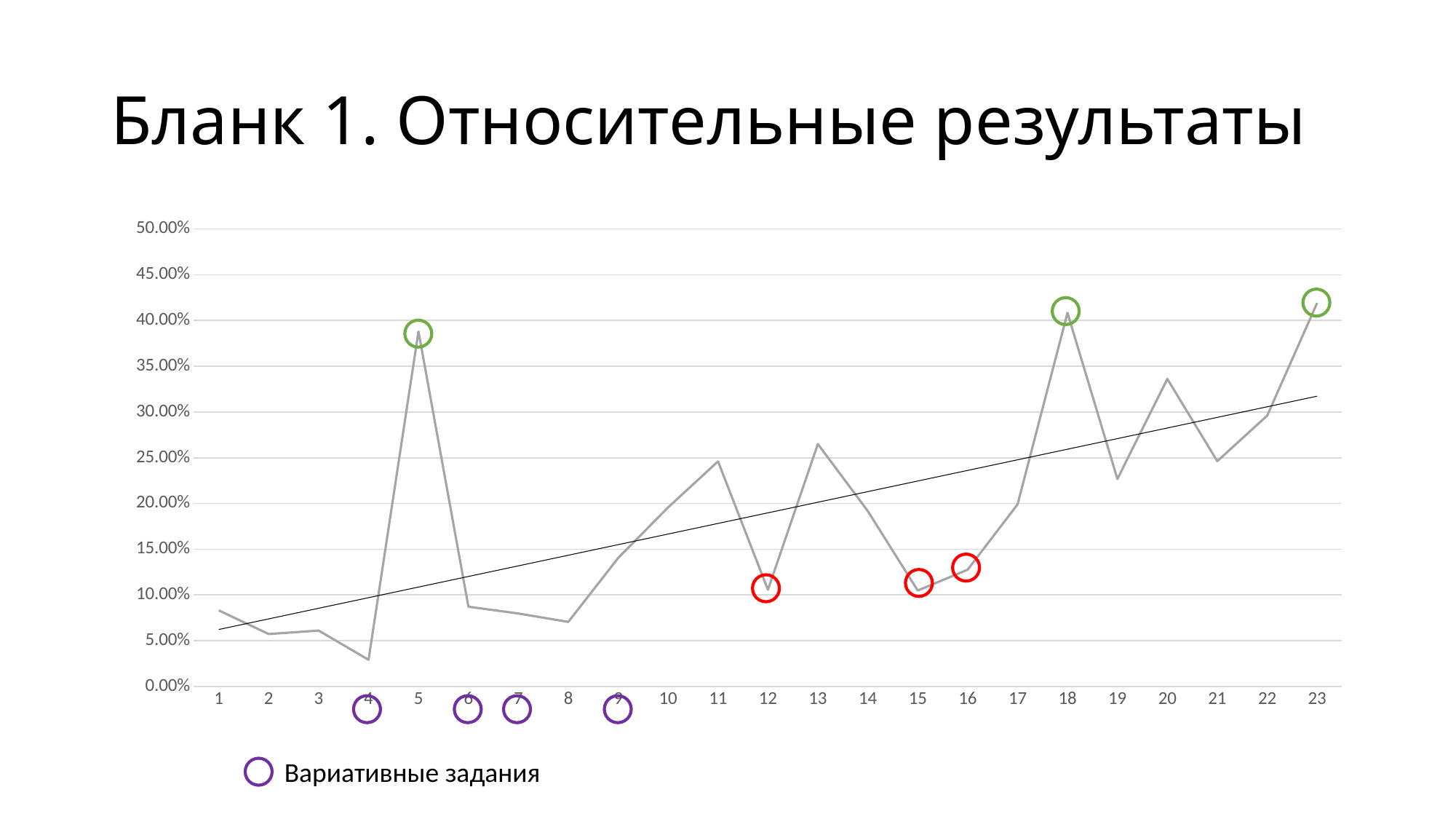
Is the value at point 20 greater or less than 30.00%? greater Which has the larger value, point 5 or point 11? 5 What kind of chart is shown on the slide? line chart How many points are plotted along the x axis? 23 Is the value at point 5 greater or less than 35.00%? greater What is the title of the slide? Бланк 1. Относительные результаты Which x-axis category has the lowest value? 4 Is the value at point 19 greater or less than 20.00%? greater What label is given to the purple circles in the legend below the chart? Вариативные задания Does the straight trend line rise or fall from left to right? rises